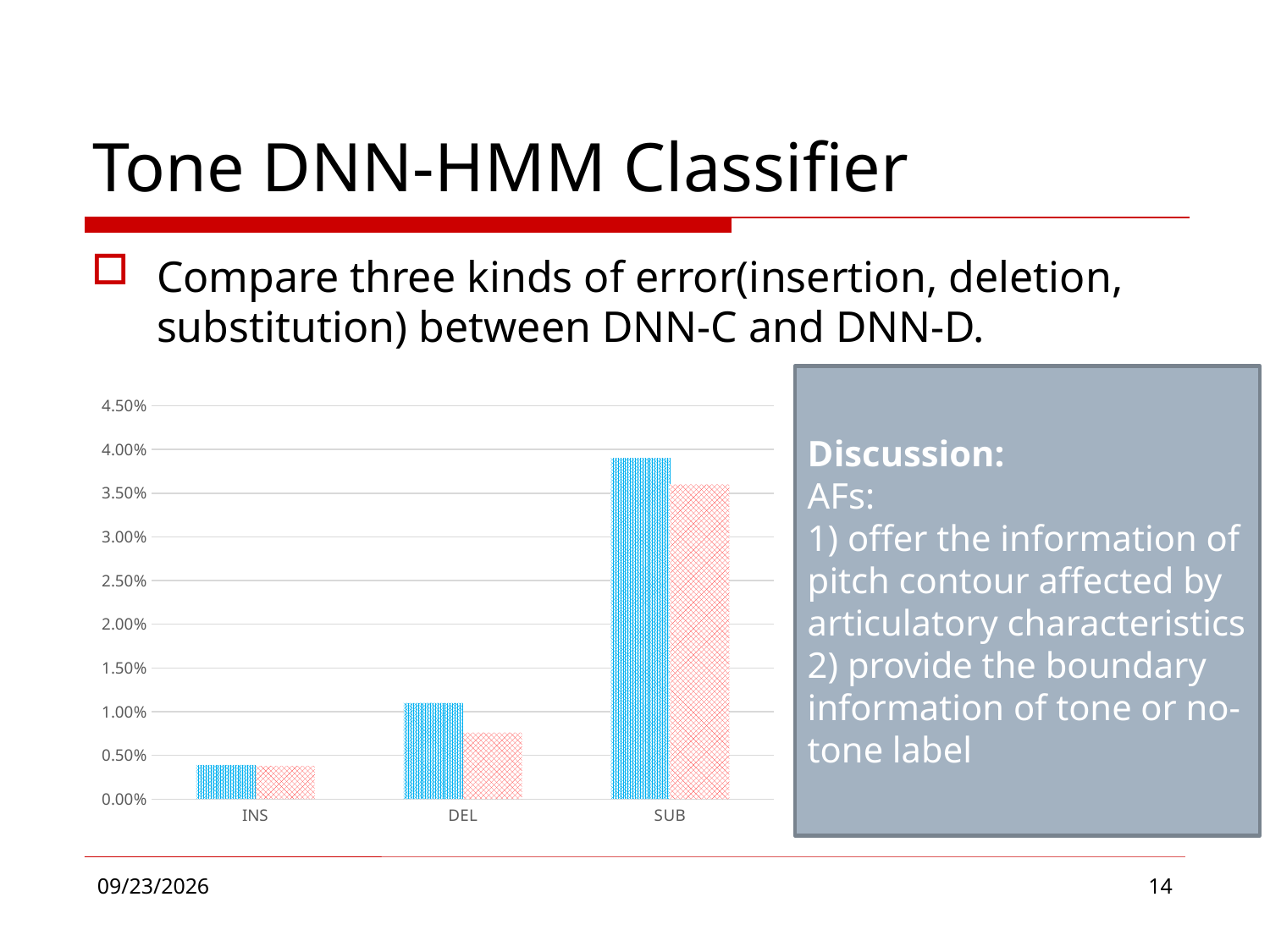
Is the value of the red bar for DEL greater or less than 1.00%? less What is the highest value labelled on the vertical axis of the chart? 4.50% Is the value of the blue bar for SUB greater or less than 3.50%? greater What kind of chart is shown on the slide? bar chart Which category has the highest bars in the chart? SUB How many categories are shown on the x axis of the chart? 3 Which category has the lowest bars in the chart? INS Is the value of the red bar for SUB greater or less than 4.00%? less For SUB, which bar is larger, the blue one or the red one? the blue one Do the bar values rise or fall going from INS to SUB along the x axis? rise